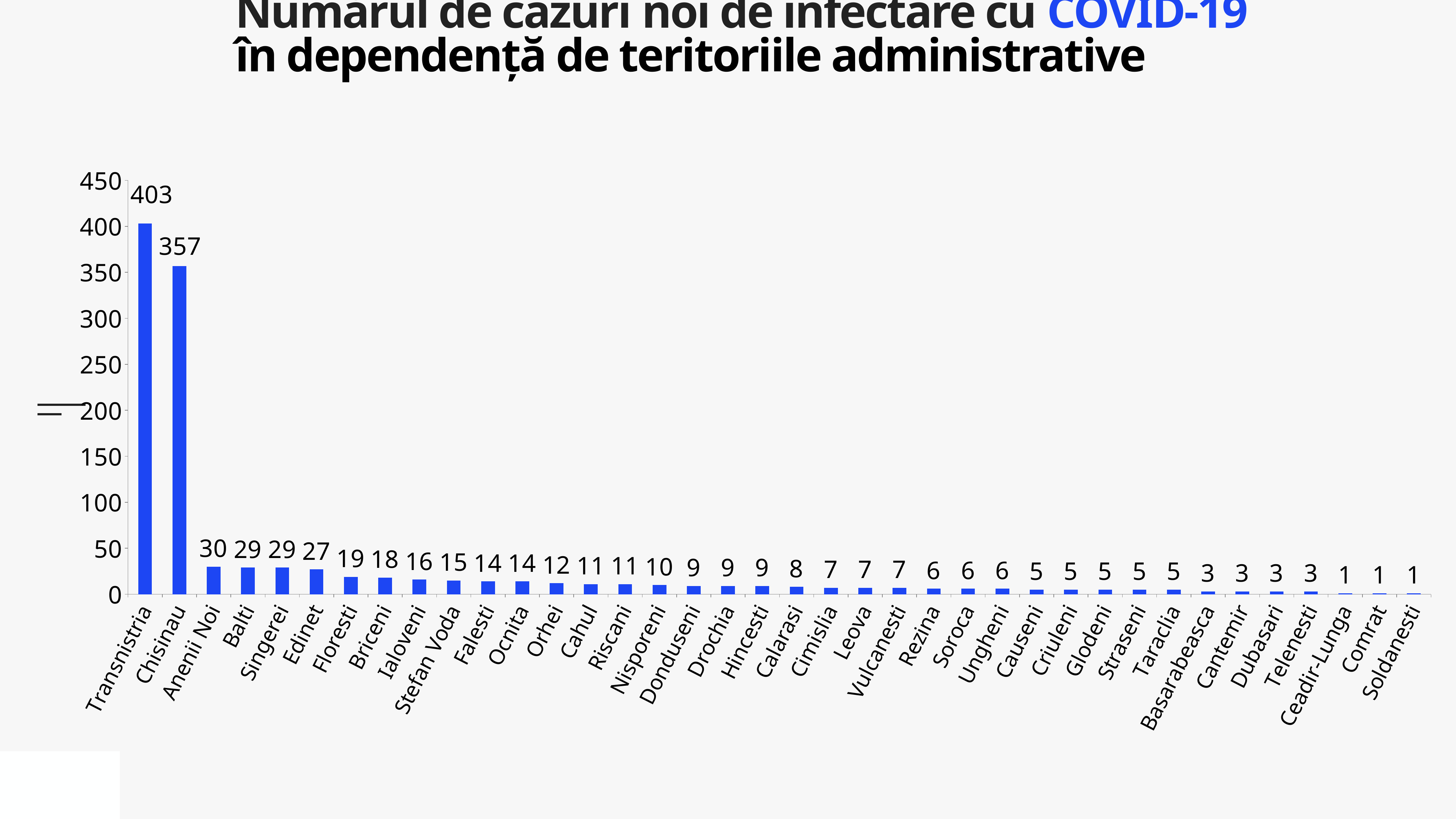
What is the value for Edinet? 27 What is the value for Telenesti? 3 How many categories are shown on the x axis? 38 What is the difference between the values for Transnistria and Chisinau? 46 Which category has the highest value? Transnistria What kind of chart is shown on the slide? bar chart What is the value for Transnistria? 403 Which is larger, the value for Anenii Noi or the value for Floresti? Anenii Noi Do the values rise or fall from left to right along the x axis? fall What is the value for Orhei? 12 What is the value for Chisinau? 357 Is the value for Chisinau greater or less than 300? greater